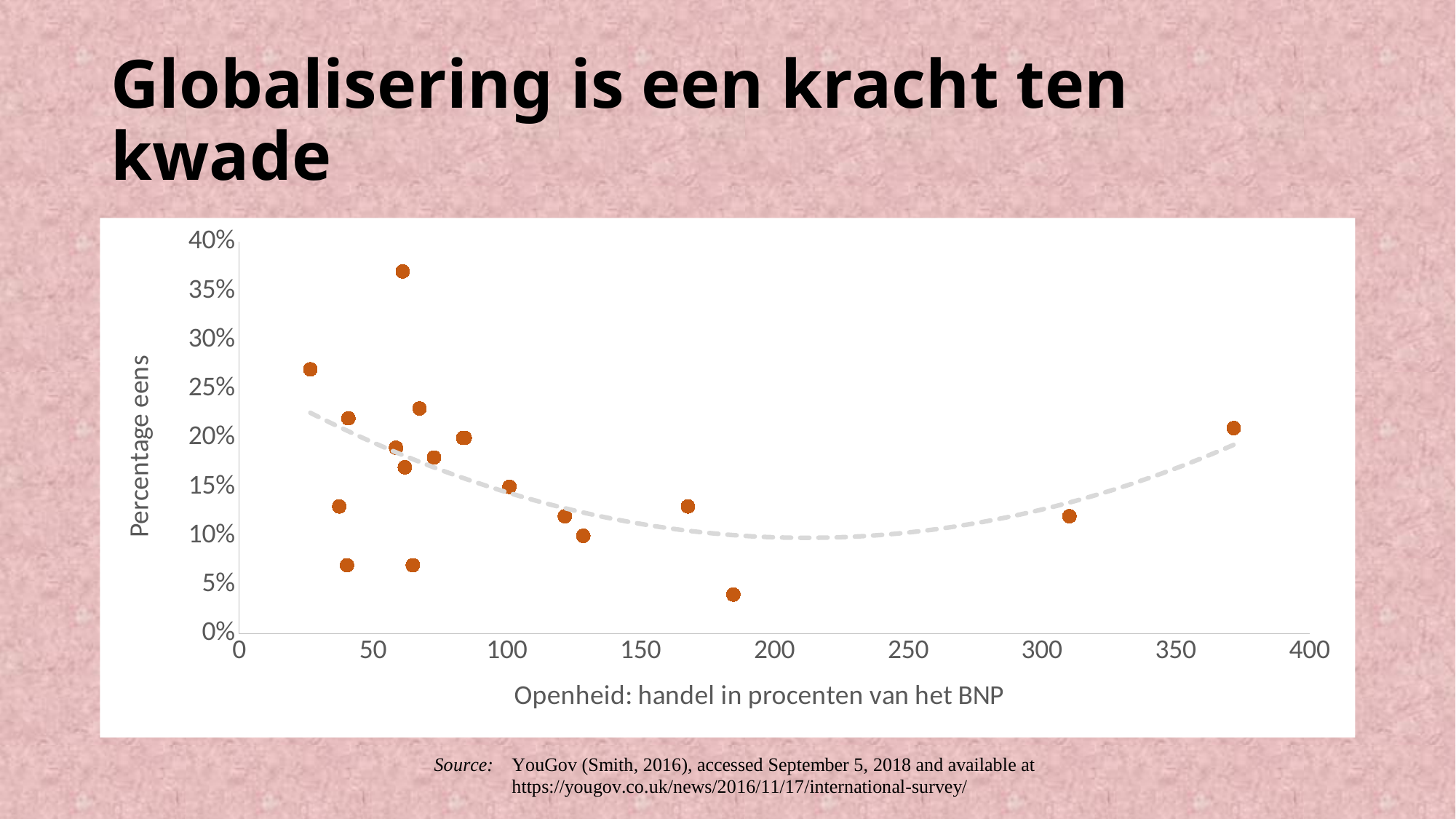
What kind of chart is shown on the slide? Scatter chart Is the y value of the lowest point in the chart greater or less than 5%? less What is the label of the y axis? Percentage eens Does the dashed trend line fall or rise as x increases from 0 to 200? falls Is the x value of the highest point in the chart greater or less than 100? less What is the label of the x axis? Openheid: handel in procenten van het BNP Does the dashed trend line fall or rise as x increases from 250 to 400? rises Is the x value of the rightmost point in the chart greater or less than 350? greater